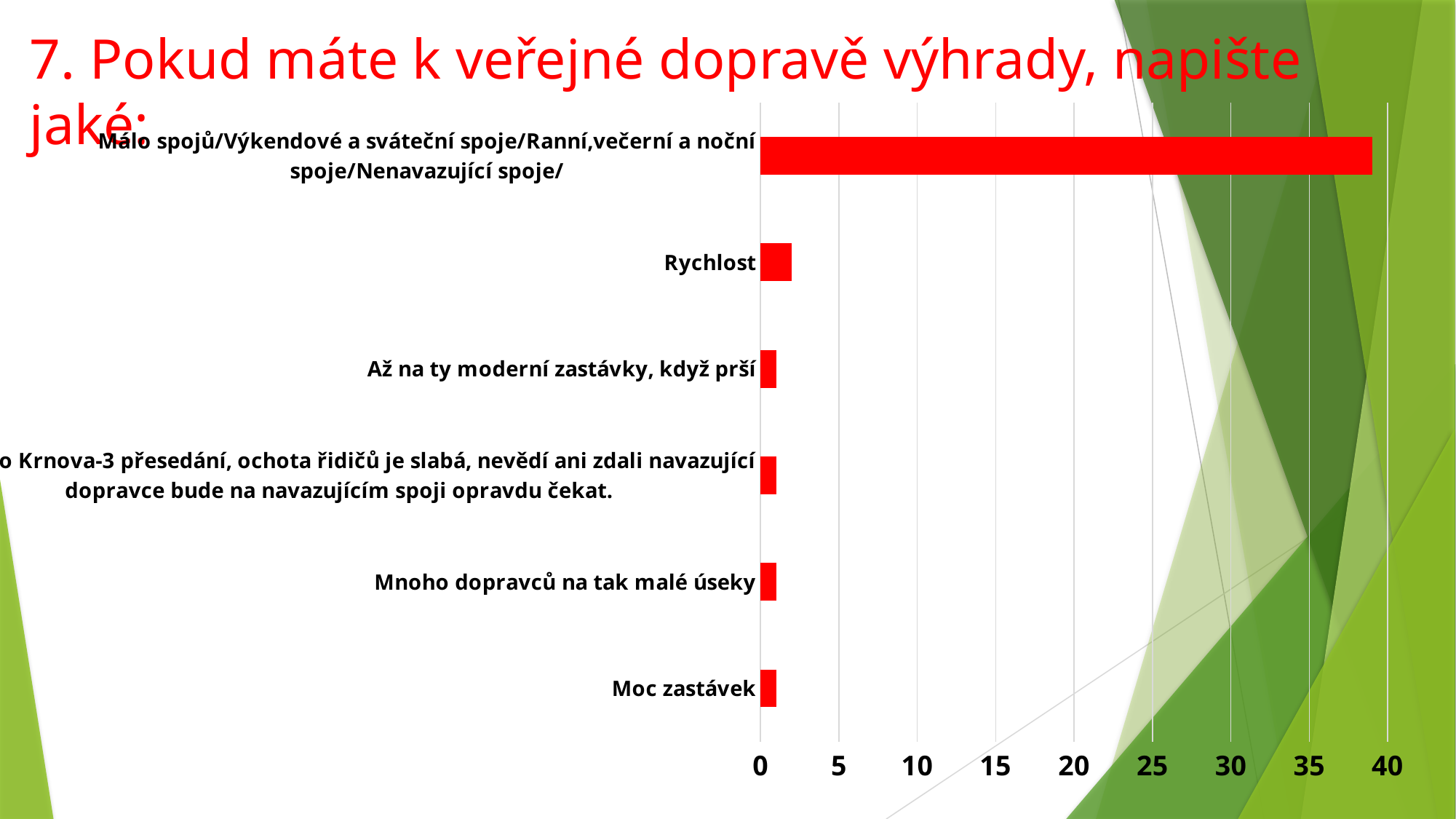
Which category has the highest value in the chart? Málo spojů/Výkendové a sváteční spoje/Ranní,večerní a noční spoje/Nenavazující spoje/ Which is larger: the value for "Rychlost" or the value for "Málo spojů/Výkendové a sváteční spoje/Ranní,večerní a noční spoje/Nenavazující spoje/"? Málo spojů/Výkendové a sváteční spoje/Ranní,večerní a noční spoje/Nenavazující spoje/ Which is larger: the value for "Rychlost" or the value for "Moc zastávek"? Rychlost Is the value for "Rychlost" greater or less than 5? less What is the highest tick value shown on the horizontal axis? 40 Is the value for "Moc zastávek" greater or less than 5? less Is the value for "Mnoho dopravců na tak malé úseky" greater or less than 10? less How many categories (complaints) are plotted in the chart? 6 What kind of chart is shown on the slide? bar chart What colour are the bars in the chart? red